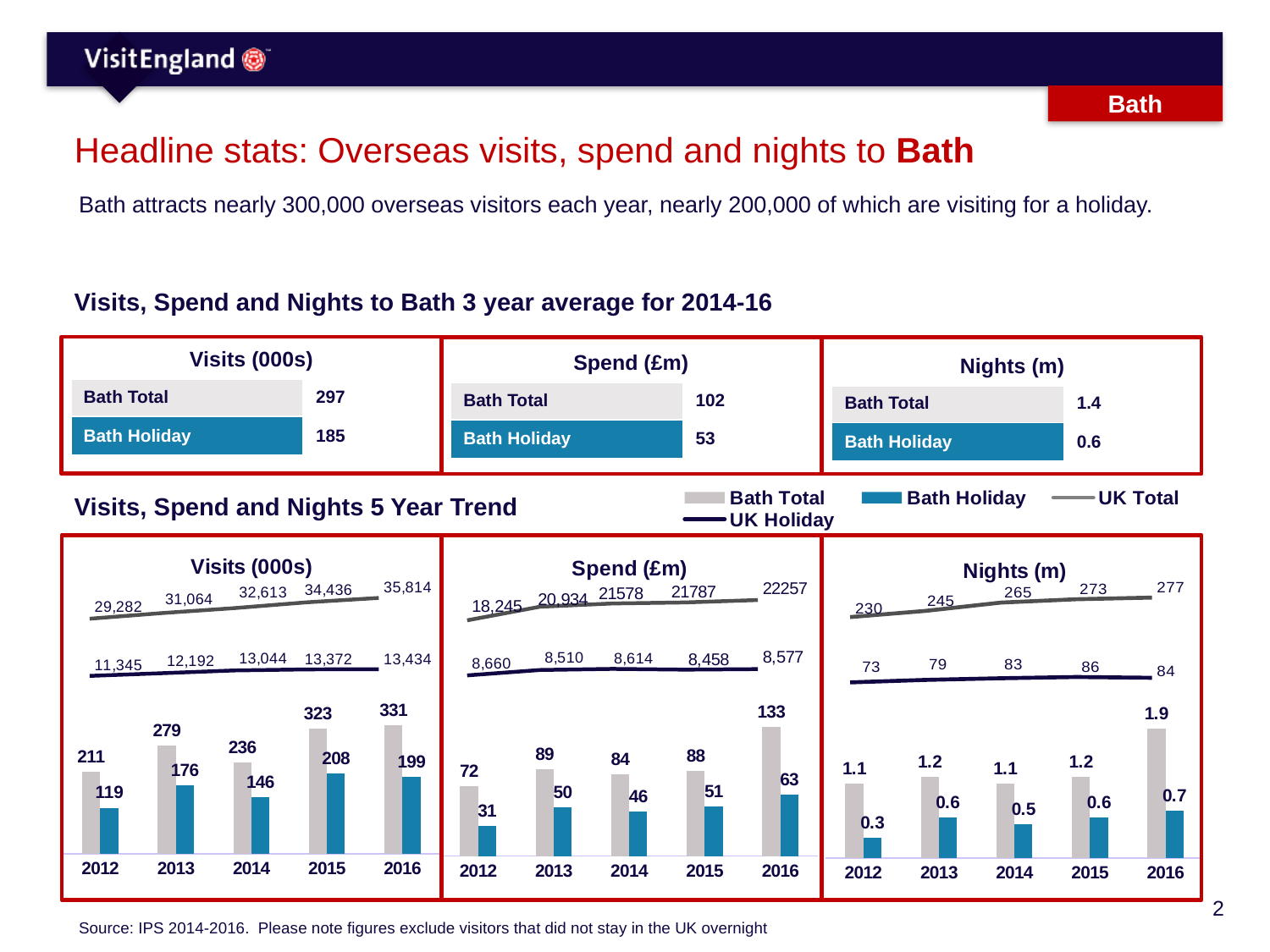
In the Visits (000s) 5 Year Trend chart, what is the UK Holiday value for 2016? 13,434 In the Nights (m) 5 Year Trend chart, what is the UK Total value for 2014? 265 In the Nights (m) 5 Year Trend chart, does the UK Total line rise or fall from 2012 to 2016? rise How many years are shown on the x axis of the Spend (£m) 5 Year Trend chart? 5 In the Visits (000s) 5 Year Trend chart, what is the Bath Holiday value for 2012? 119 In the Spend (£m) 5 Year Trend chart, is the Bath Holiday value for 2016 larger or smaller than the Bath Holiday value for 2015? larger In the Visits (000s) 5 Year Trend chart, what is the Bath Total value for 2016? 331 In the Visits (000s) 5 Year Trend chart, what is the difference between the Bath Total values for 2013 and 2012? 68 In the Nights (m) 5 Year Trend chart, what is the Bath Total value for 2016? 1.9 How many series does the legend for the 5 Year Trend charts list? 4 In the Spend (£m) 5 Year Trend chart, which year has the highest Bath Total value? 2016 In the Spend (£m) 5 Year Trend chart, which year has the lowest Bath Holiday value? 2012